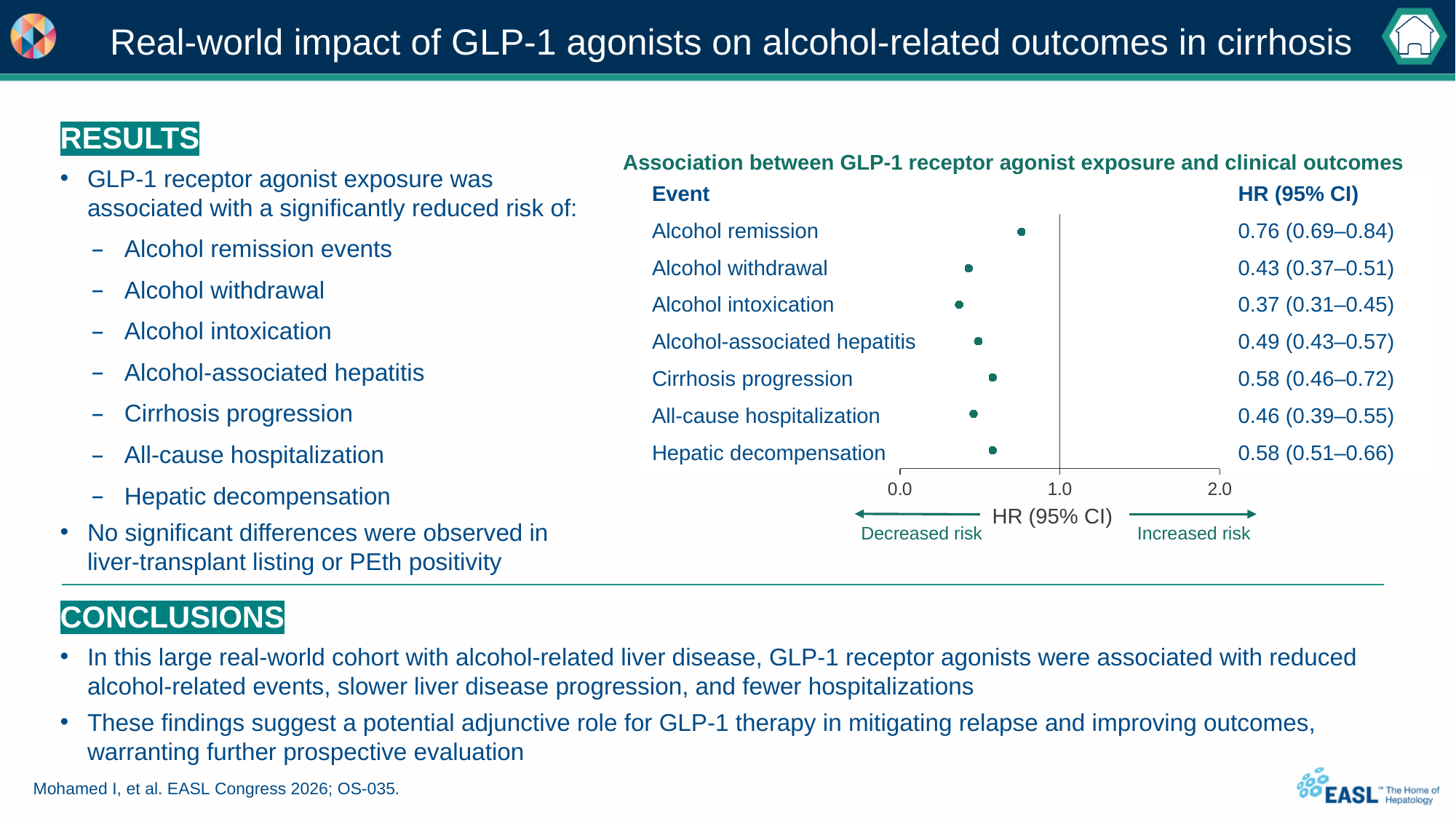
Which has the larger hazard ratio, alcohol-associated hepatitis or cirrhosis progression? Cirrhosis progression What is the hazard ratio (95% CI) for hepatic decompensation? 0.58 (0.51–0.66) What is the title of the chart? Association between GLP-1 receptor agonist exposure and clinical outcomes Which event has the lowest hazard ratio? Alcohol intoxication What is the difference between the hazard ratio for alcohol remission and the hazard ratio for alcohol withdrawal? 0.33 Is the hazard ratio for alcohol remission greater or less than 1.0? less Which event has the highest hazard ratio? Alcohol remission What is the label on the x axis of the chart? HR (95% CI) What is the hazard ratio (95% CI) for all-cause hospitalization? 0.46 (0.39–0.55) What is the hazard ratio (95% CI) for alcohol intoxication? 0.37 (0.31–0.45) What is the hazard ratio (95% CI) for alcohol remission? 0.76 (0.69–0.84) How many events are plotted in the chart? 7